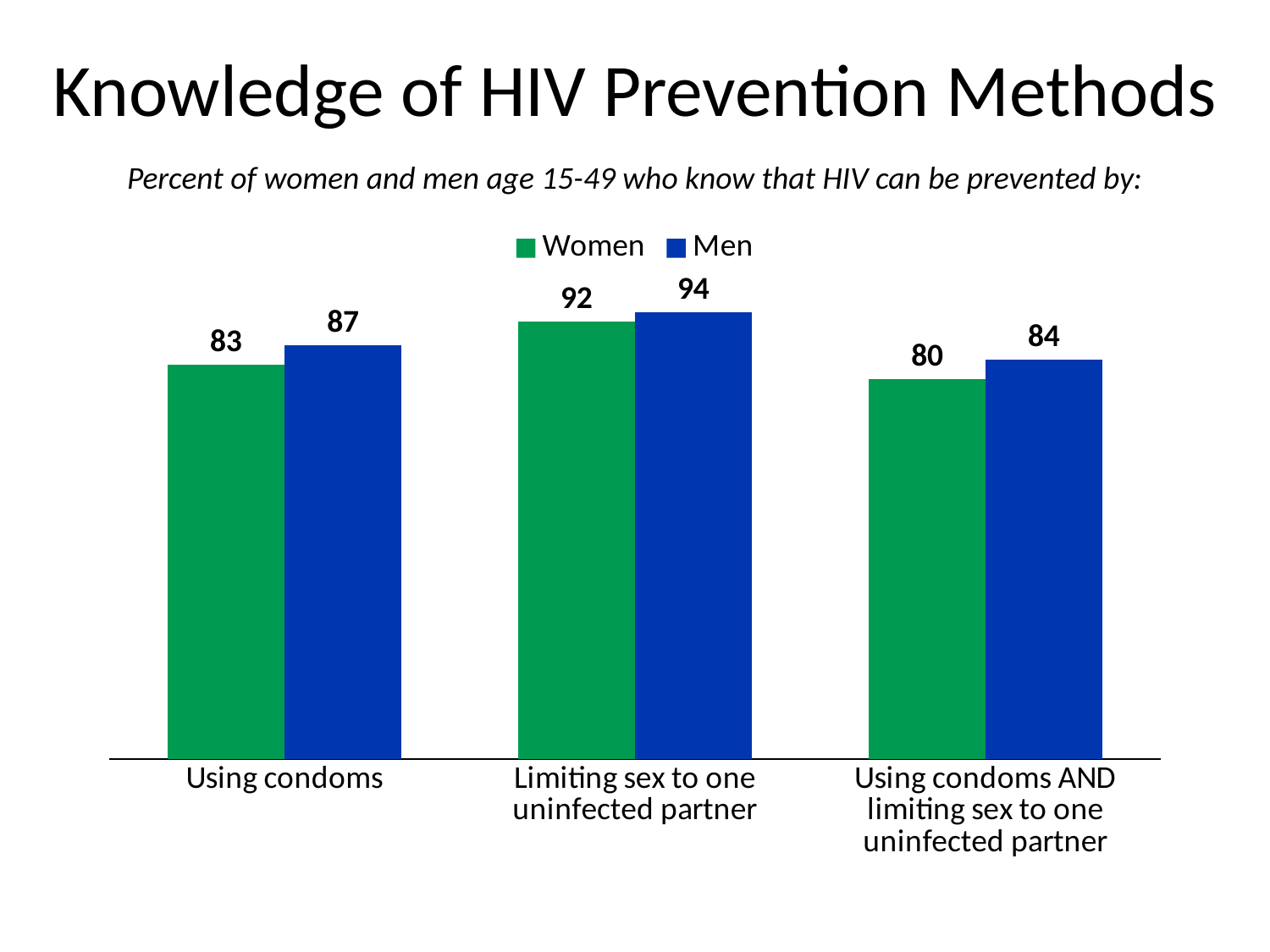
What percent of women know that HIV can be prevented by using condoms? 83 Which colour represents the Men series in the chart? Blue What percent of men know that HIV can be prevented by limiting sex to one uninfected partner? 94 What is the difference between the men's and women's values for using condoms? 4 What kind of chart is shown on the slide? Bar chart Which prevention method has the lowest value for women? Using condoms AND limiting sex to one uninfected partner For 'Using condoms AND limiting sex to one uninfected partner', which is larger, the value for women or for men? Men What is the difference between the women's values for limiting sex to one uninfected partner and for using condoms? 9 How many series does the legend list? 2 Which prevention method has the highest value for men? Limiting sex to one uninfected partner How many prevention methods (categories) are shown on the x axis? 3 What is the value for women for 'Using condoms AND limiting sex to one uninfected partner'? 80